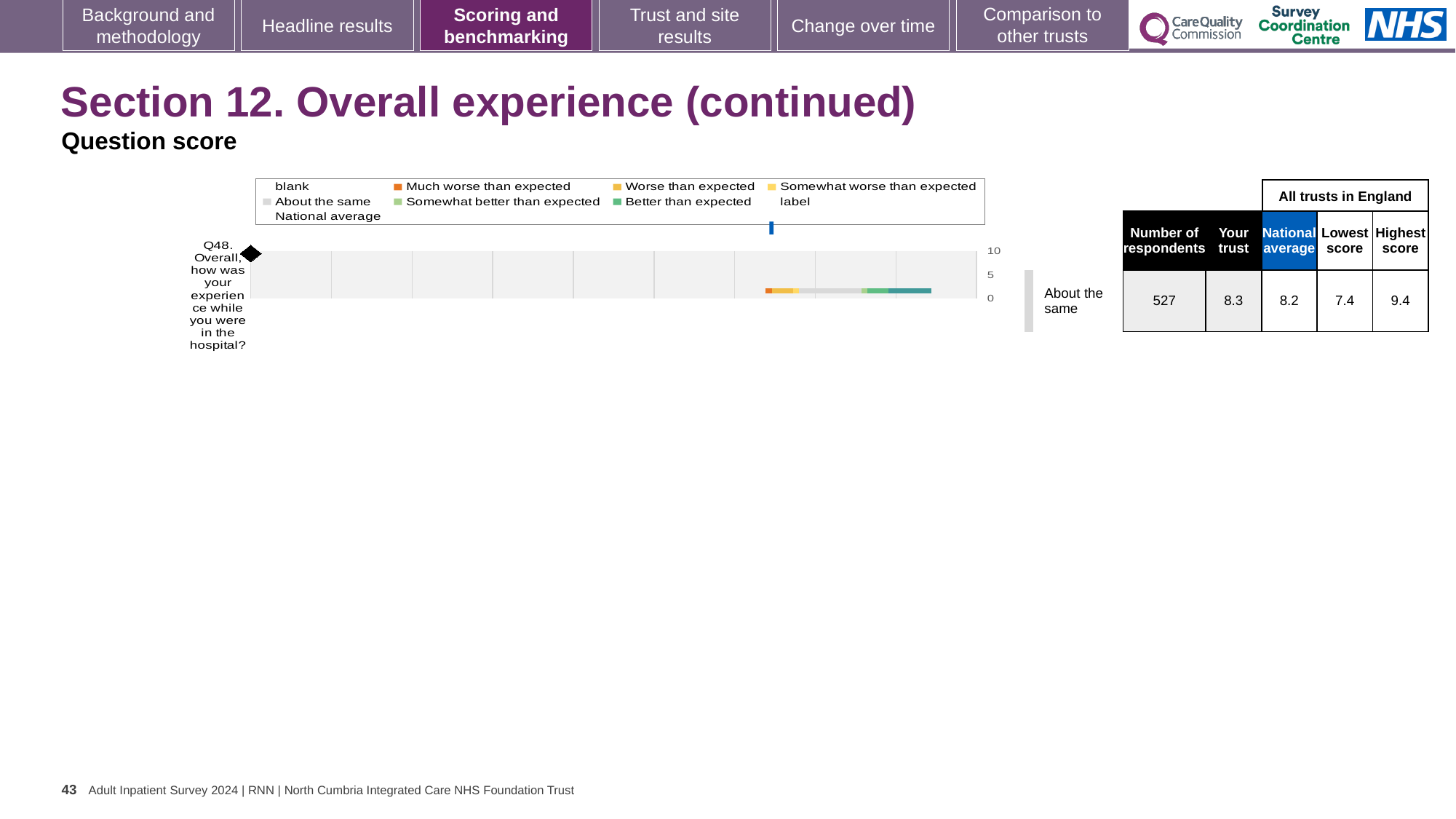
Which question is plotted in the chart? Q48. Overall, how was your experience while you were in the hospital? Which benchmarking category is the trust's Q48 result placed in? About the same Which is larger for Q48, the 'Your trust' score or the National average? Your trust How many survey questions are plotted in the chart? 1 In the table next to the chart, what is the Lowest score among all trusts in England for Q48? 7.4 In the table next to the chart, what is the National average score for Q48? 8.2 What kind of chart is shown on the slide? Bar chart What is the difference between the Highest score and the Lowest score for Q48? 2.0 What colour does the legend use for 'Much worse than expected'? Orange In the table next to the chart, what is the Highest score among all trusts in England for Q48? 9.4 In the table next to the chart, what is the 'Your trust' score for Q48? 8.3 How many respondents answered Q48 according to the table next to the chart? 527